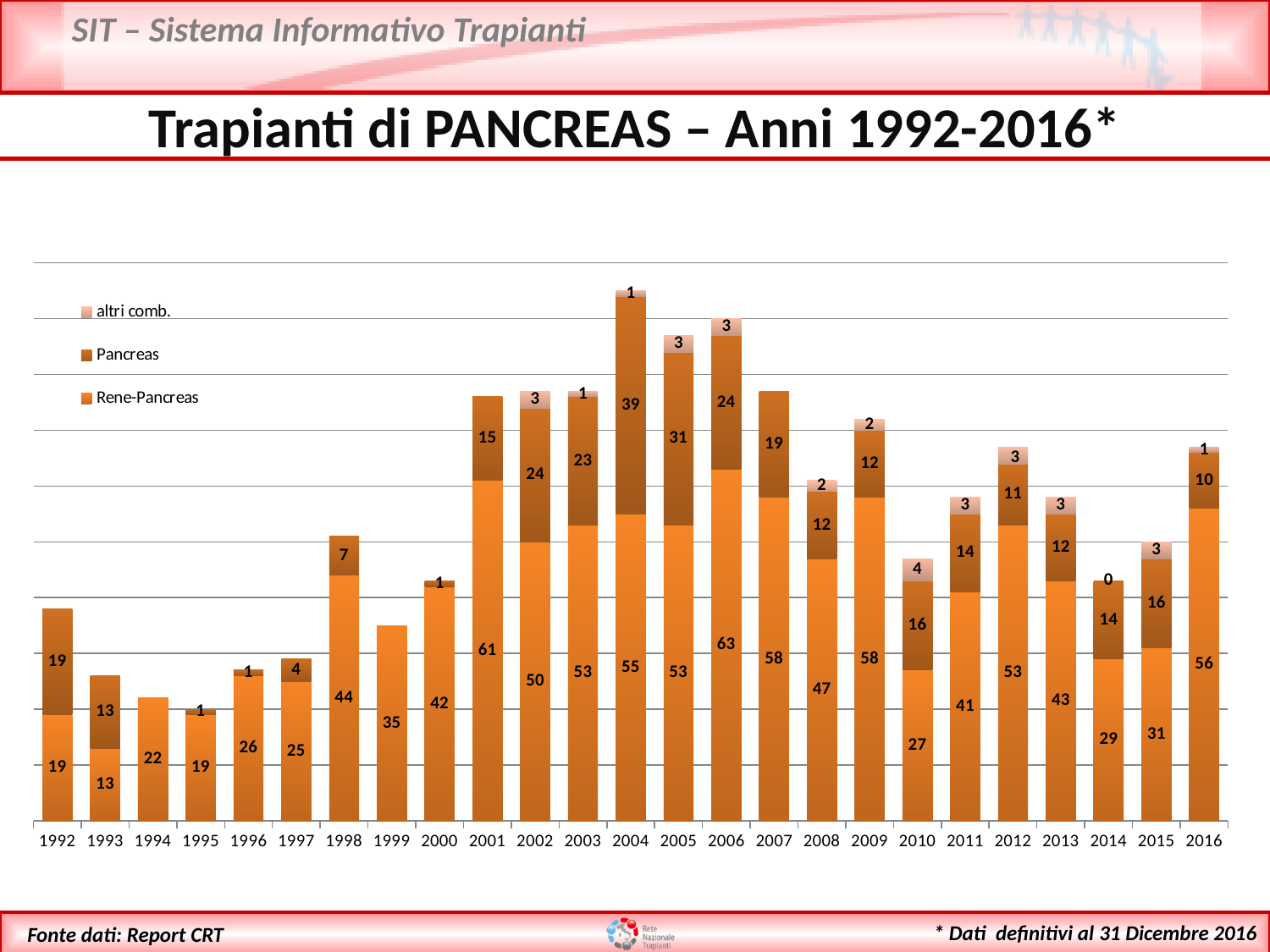
What is the altri comb. value for 2010? 4 What is the difference between the Rene-Pancreas values for 2001 and 2000? 19 How many series does the legend list? 3 Which year has the highest Pancreas value? 2004 Which is larger, the Rene-Pancreas value for 2012 or for 2013? 2012 What is the total of the stacked bar for 2016? 67 What is the total of the stacked bar for 2004? 95 What is the Pancreas value for 2004? 39 Which year has the highest Rene-Pancreas value? 2006 What is the Rene-Pancreas value for 2006? 63 How many years are shown on the x axis? 25 Which year has the lowest Rene-Pancreas value? 1993